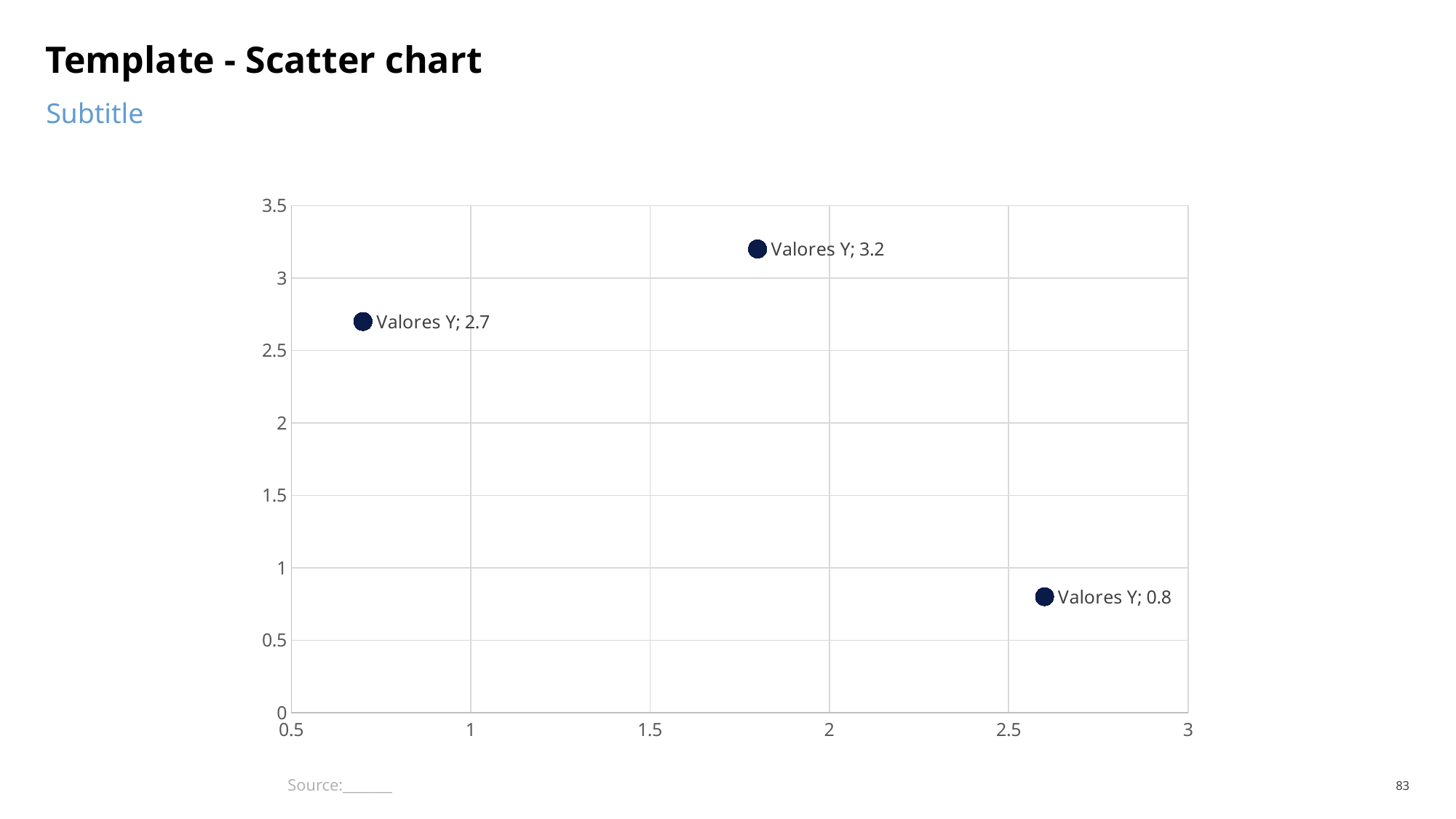
What is the y value of the rightmost point on the chart? 0.8 What is the difference between the y values of the leftmost point and the middle point? 0.5 What series name appears in the data labels on the chart? Valores Y What is the difference between the highest and lowest labelled y values? 2.4 Is the x value of the point labelled 2.7 greater or less than 1? less What kind of chart is shown on the slide? scatter chart Is the x value of the point labelled 0.8 greater or less than 2.5? greater What is the highest y value labelled on the chart? 3.2 How many data points are plotted on the chart? 3 Which has the larger y value, the leftmost point or the rightmost point? the leftmost point What is the y value of the leftmost point on the chart? 2.7 What is the lowest y value labelled on the chart? 0.8